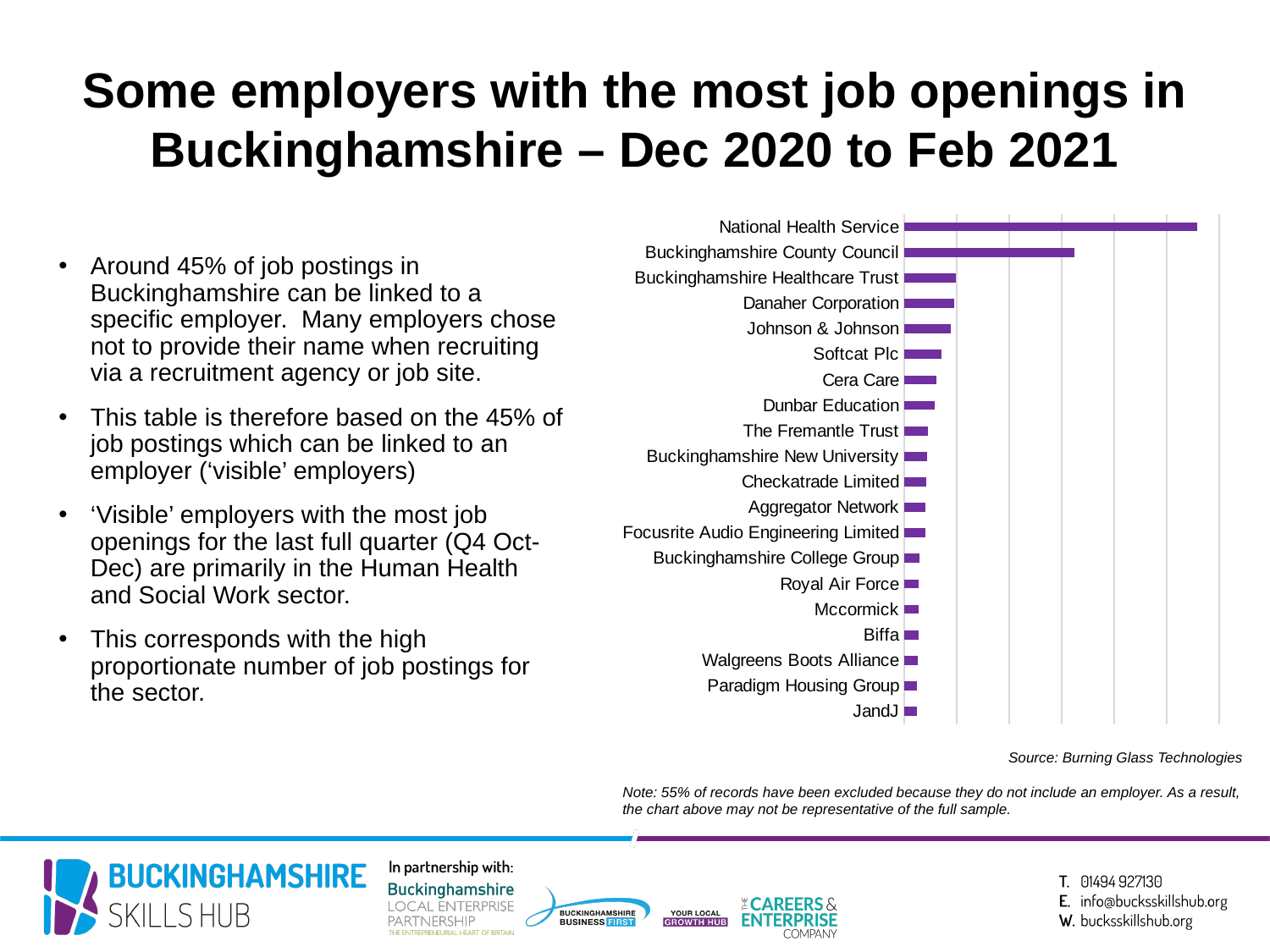
How many employers are listed in the chart? 20 Which employer is listed at the bottom of the chart? JandJ What kind of chart is shown on the slide? Bar chart Which has more job openings, Buckinghamshire County Council or Buckinghamshire Healthcare Trust? Buckinghamshire County Council Which employer has the second-longest bar in the chart? Buckinghamshire County Council Do the bar lengths increase or decrease going from the top of the chart to the bottom? Decrease What is the source of the data shown in the chart? Burning Glass Technologies Which has more job openings, Cera Care or Royal Air Force? Cera Care Which has more job openings, National Health Service or Buckinghamshire County Council? National Health Service Which employer has the highest number of job openings in the chart? National Health Service